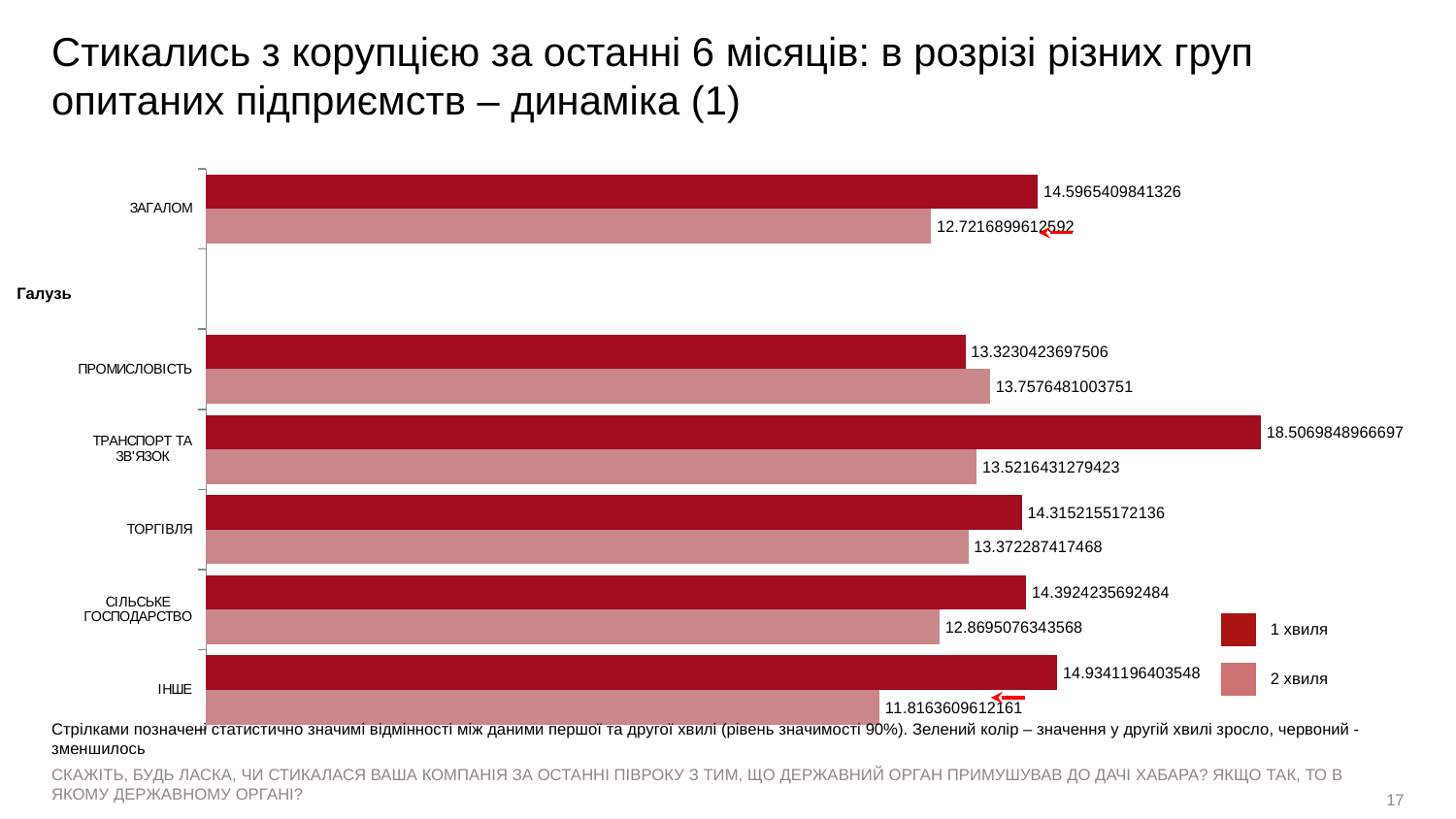
For ПРОМИСЛОВІСТЬ, which series has the larger value, 1 хвиля or 2 хвиля? 2 хвиля What are the two entries listed in the legend? 1 хвиля and 2 хвиля Which category has the lowest value in the 2 хвиля series? ІНШЕ What is the value for ІНШЕ in the 2 хвиля series? 11.8163609612161 How many categories are plotted on the chart? 6 What kind of chart is shown on the slide? bar chart Which category has the highest value in the 2 хвиля series? ПРОМИСЛОВІСТЬ Which category has the highest value in the 1 хвиля series? ТРАНСПОРТ ТА ЗВ'ЯЗОК What is the difference between the 1 хвиля and 2 хвиля values for ЗАГАЛОМ? 1.8748510228734 What is the value for ЗАГАЛОМ in the 1 хвиля series? 14.5965409841326 How many series does the legend list? 2 What is the value for ТРАНСПОРТ ТА ЗВ'ЯЗОК in the 2 хвиля series? 13.5216431279423